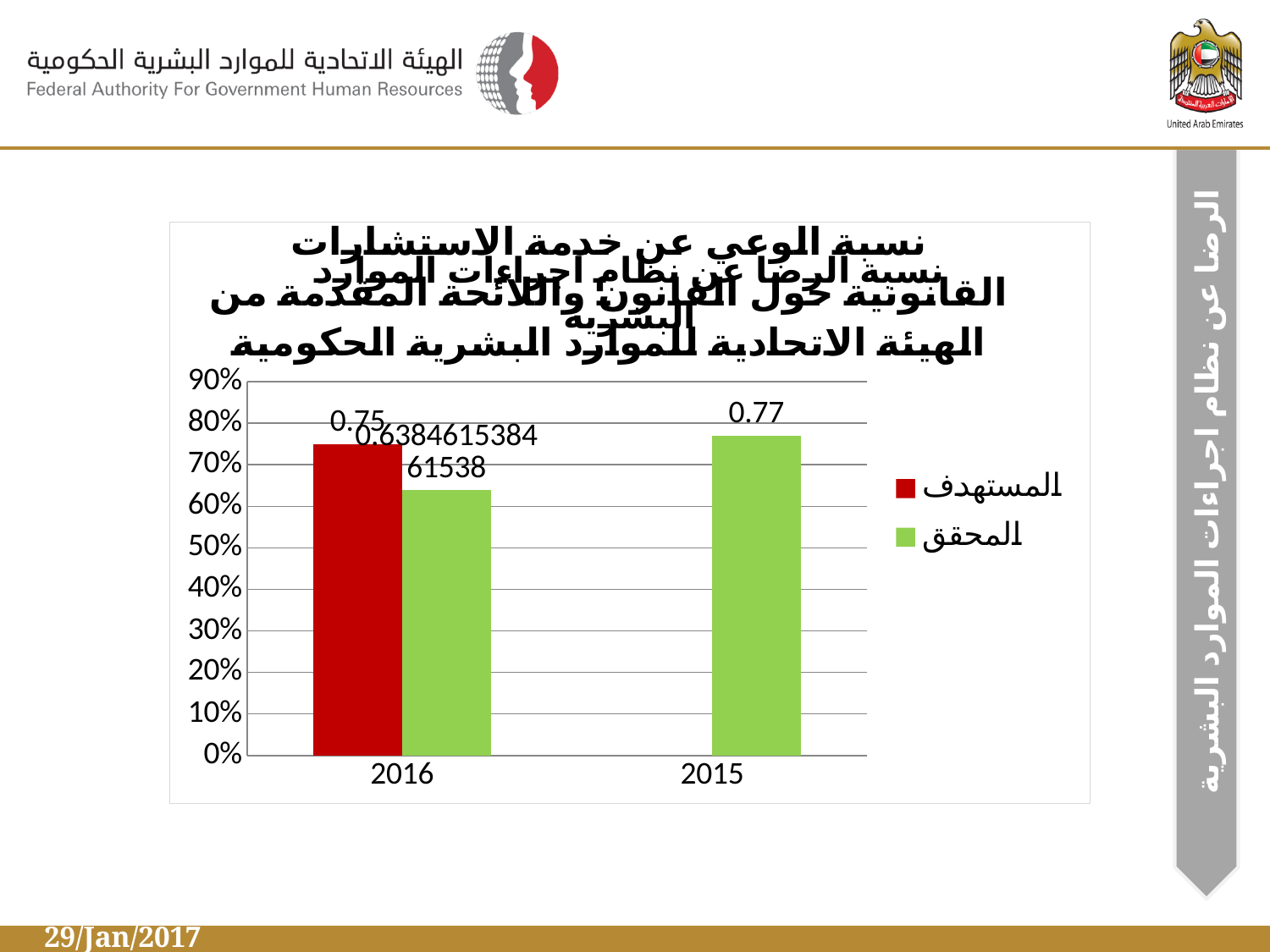
Which year has the higher value for المحقق, 2015 or 2016? 2015 What colour represents المستهدف in the legend? red How many series does the legend list? 2 What is the value of المحقق for 2015? 0.77 Is the value of المستهدف for 2016 greater or less than 70%? greater What is the difference between المحقق for 2015 and المستهدف for 2016? 0.02 Is the value of المحقق for 2016 greater or less than 70%? less Which bar is the lowest in the chart? المحقق for 2016 What is the value of المستهدف for 2016? 0.75 How many categories are shown on the x axis? 2 What kind of chart is shown on the slide? bar chart For 2016, which is larger: المستهدف or المحقق? المستهدف